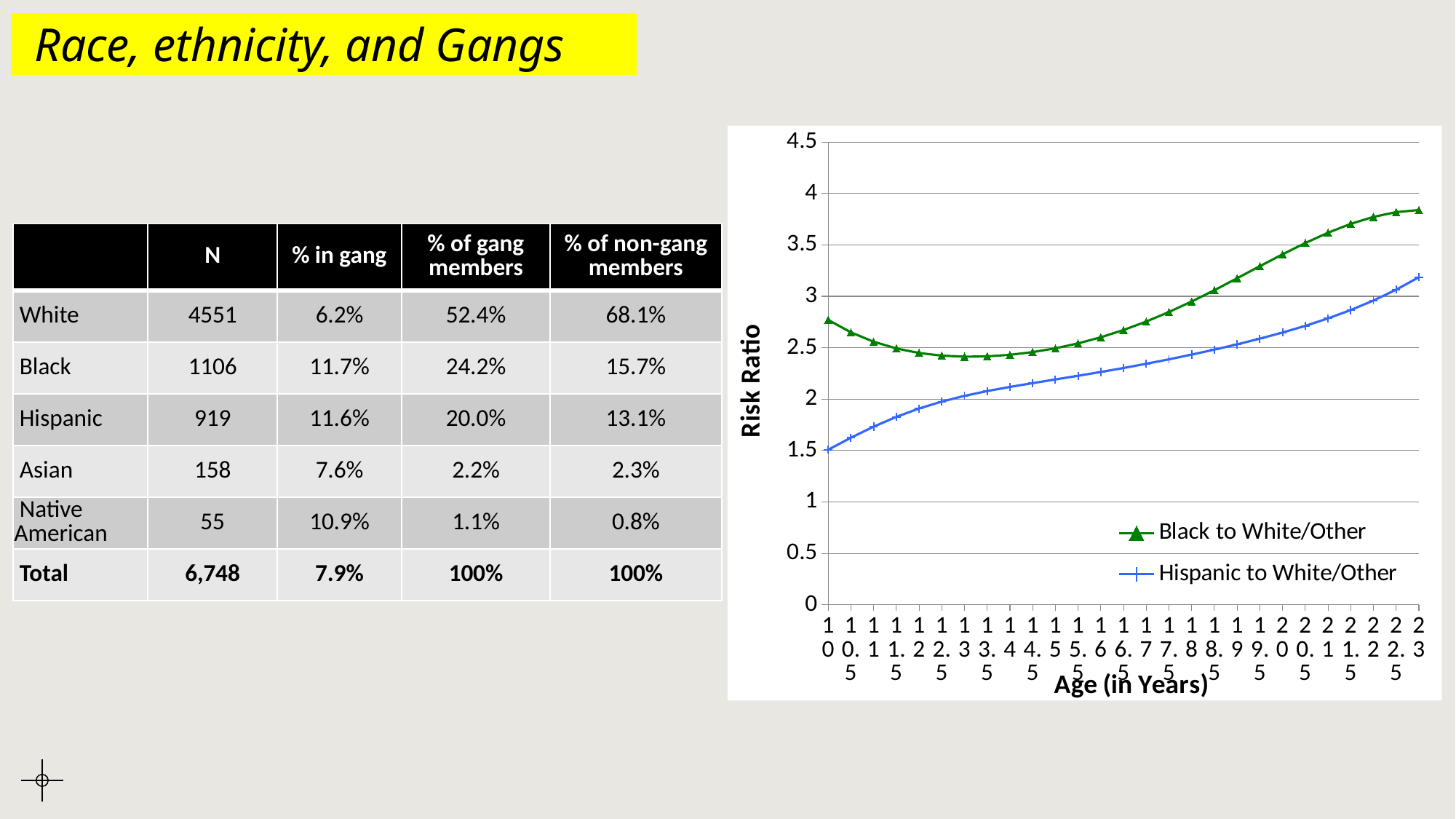
What is the title of the chart's horizontal axis? Age (in Years) Does the Hispanic to White/Other risk ratio rise or fall as age increases from 10 to 23? rises Is the Hispanic to White/Other risk ratio at age 10 greater or less than 2? less What is the title of the chart's vertical axis? Risk Ratio At age 23, which series has the higher risk ratio, Black to White/Other or Hispanic to White/Other? Black to White/Other Is the Black to White/Other risk ratio at age 13 greater or less than 2.5? less Is the Black to White/Other risk ratio at age 10 greater or less than 2.5? greater What kind of chart is shown on the slide? line chart How many series does the chart's legend list? 2 How many age points are plotted along the x axis of the chart? 27